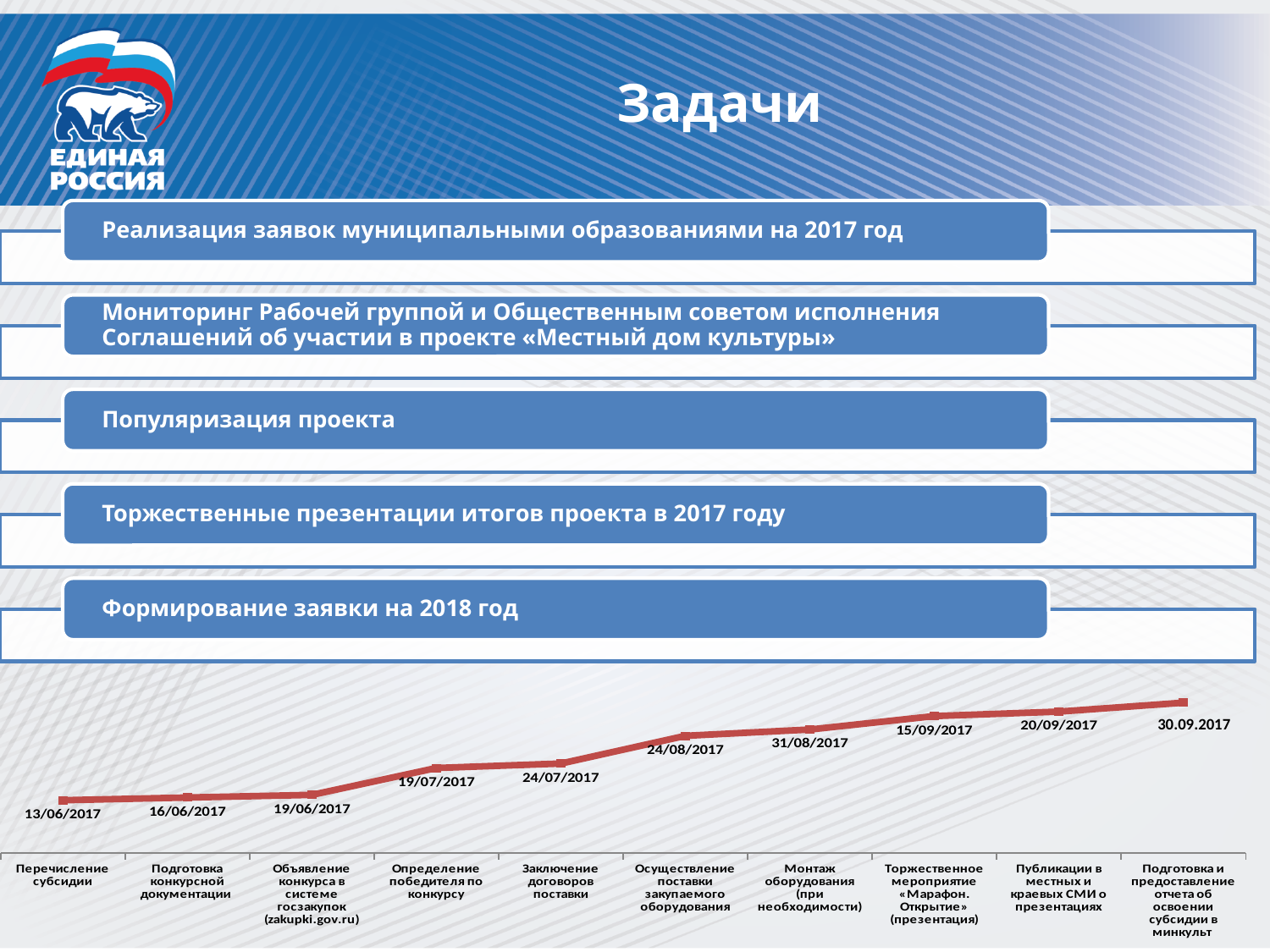
What date is labelled for the stage "Осуществление поставки закупаемого оборудования"? 24/08/2017 What kind of chart is shown at the bottom of the slide? line chart Which stage has the earliest date on the timeline chart? Перечисление субсидии What date is labelled for the stage "Торжественное мероприятие «Марафон. Открытие» (презентация)"? 15/09/2017 What date is labelled for the stage "Заключение договоров поставки"? 24/07/2017 What date is labelled for the last stage, "Подготовка и предоставление отчета об освоении субсидии в минкульт"? 30.09.2017 What date is labelled for the stage "Перечисление субсидии"? 13/06/2017 What date is labelled for the stage "Определение победителя по конкурсу"? 19/07/2017 Does the line in the timeline chart rise or fall from left to right? rise How many stages (categories) are plotted along the x axis of the timeline chart? 10 What date is labelled for the stage "Монтаж оборудования (при необходимости)"? 31/08/2017 What date is labelled for the stage "Подготовка конкурсной документации"? 16/06/2017